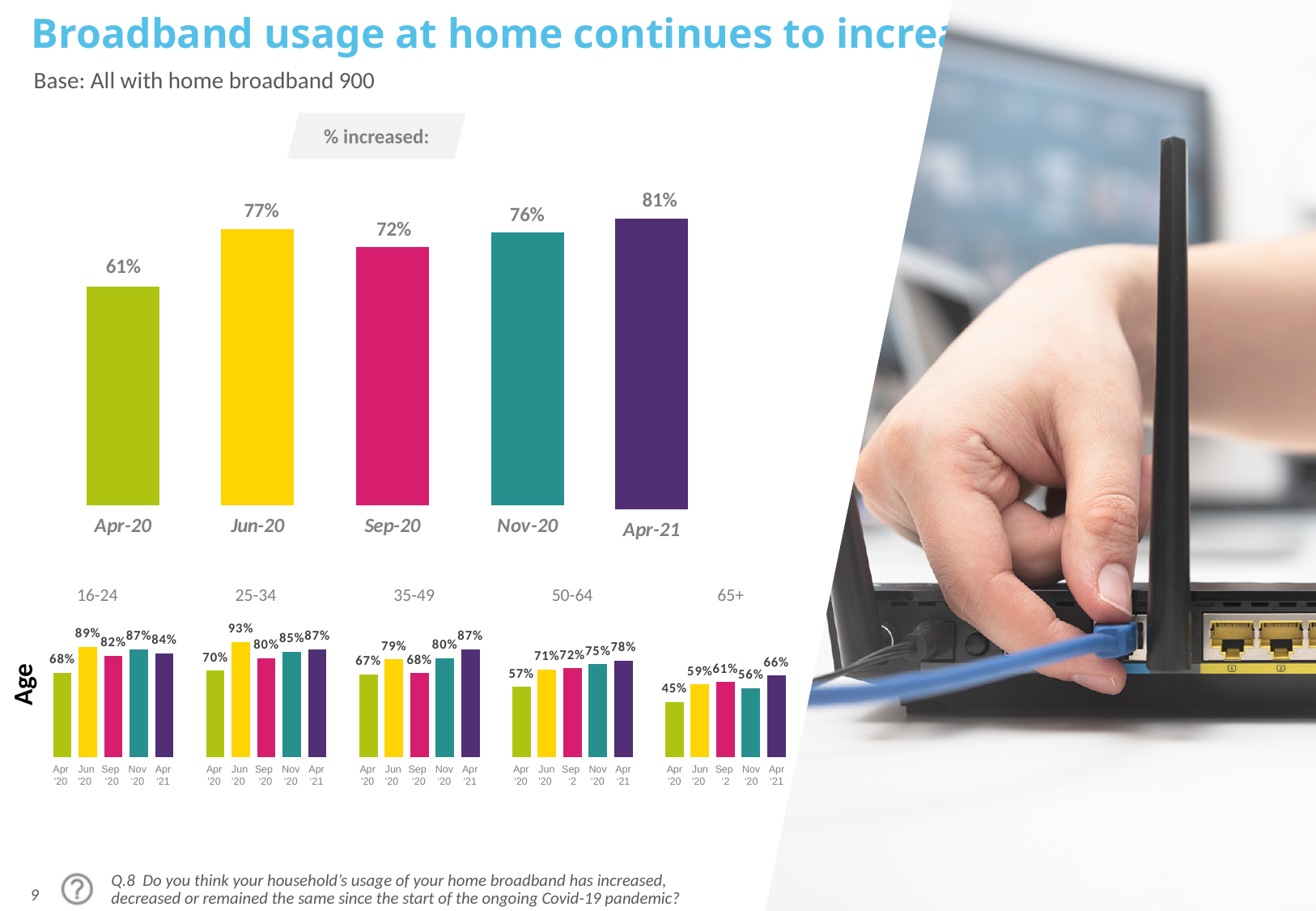
How many bars are in the main '% increased' chart? 5 In the 50-64 age chart, what is the difference between the Apr '21 and Apr '20 values? 21% In the main '% increased' chart, what is the value for Apr-20? 61% In the main '% increased' chart, which period has the lowest value? Apr-20 In the 35-49 age chart, which period has the highest value? Apr '21 In the main '% increased' chart, which period has the highest value? Apr-21 In the 25-34 age chart, what is the value for Jun '20? 93% In the main '% increased' chart, what is the difference between the Jun-20 and Sep-20 values? 5% In the 65+ age chart, what is the value for Apr '20? 45% What type of chart is the main '% increased' chart? Bar chart In the main '% increased' chart, which is larger, the value for Jun-20 or Nov-20? Jun-20 In the main '% increased' chart, what is the value for Apr-21? 81%